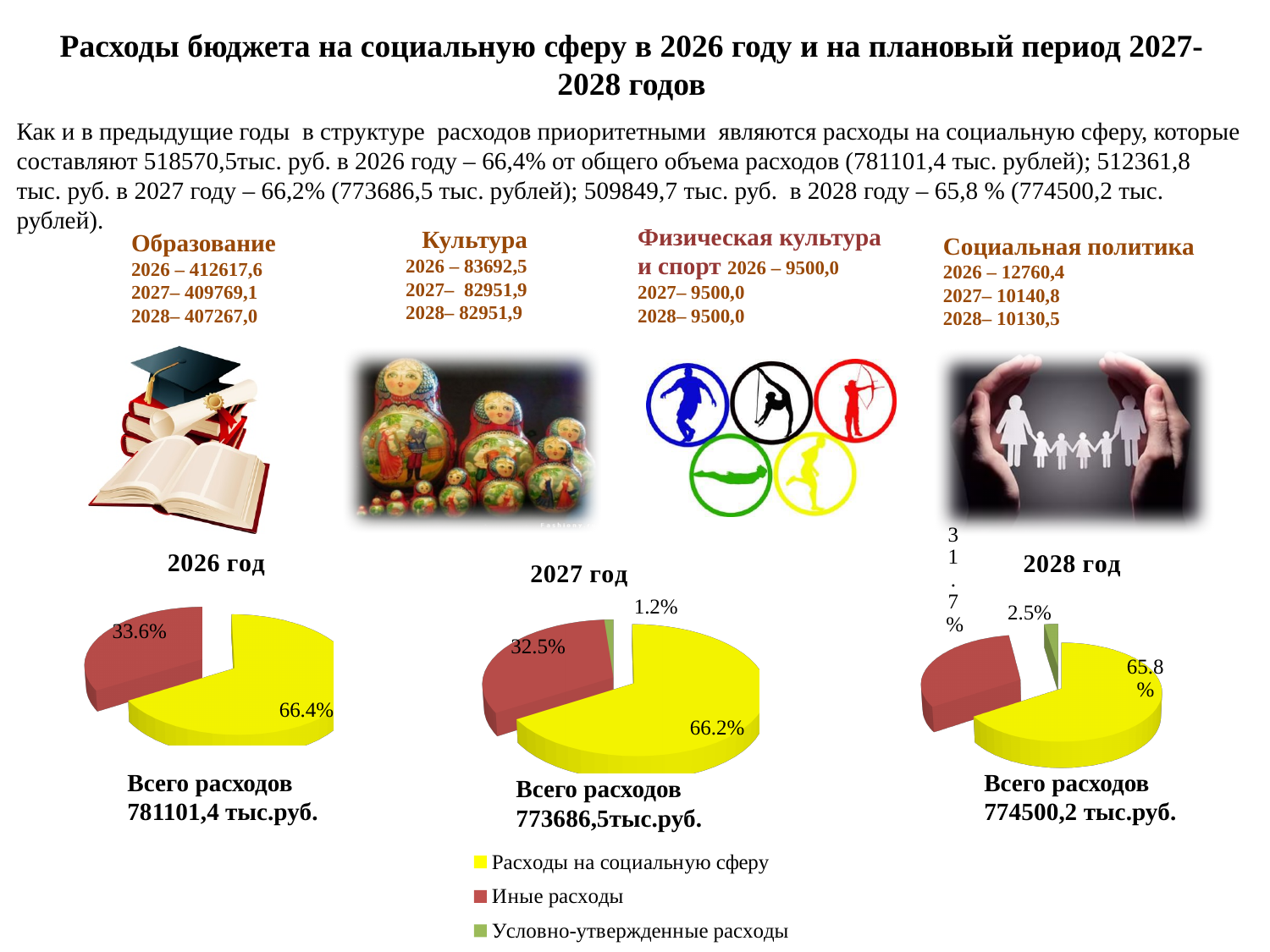
In the 2027 год pie chart, what share is labelled on the green slice (Условно-утвержденные расходы)? 1.2% In the 2028 год pie chart, which slice is the smallest? Условно-утвержденные расходы In the 2027 год pie chart, which slice is the largest? Расходы на социальную сферу In the 2027 год pie chart, what is the difference between the yellow slice (66.2%) and the red slice (32.5%)? 33.7% In the 2026 год pie chart, what share is labelled on the red slice (Иные расходы)? 33.6% In the 2027 год pie chart, what share is labelled on the red slice (Иные расходы)? 32.5% What type of chart is used for 2026 год, 2027 год and 2028 год? Pie chart How many slices does the 2026 год pie chart have? 2 In the 2028 год pie chart, what share is labelled on the yellow slice (Расходы на социальную сферу)? 65.8% How many entries does the shared legend below the pie charts list? 3 In the 2026 год pie chart, what share is labelled on the yellow slice (Расходы на социальную сферу)? 66.4% In the 2028 год pie chart, what share is labelled on the green slice (Условно-утвержденные расходы)? 2.5%